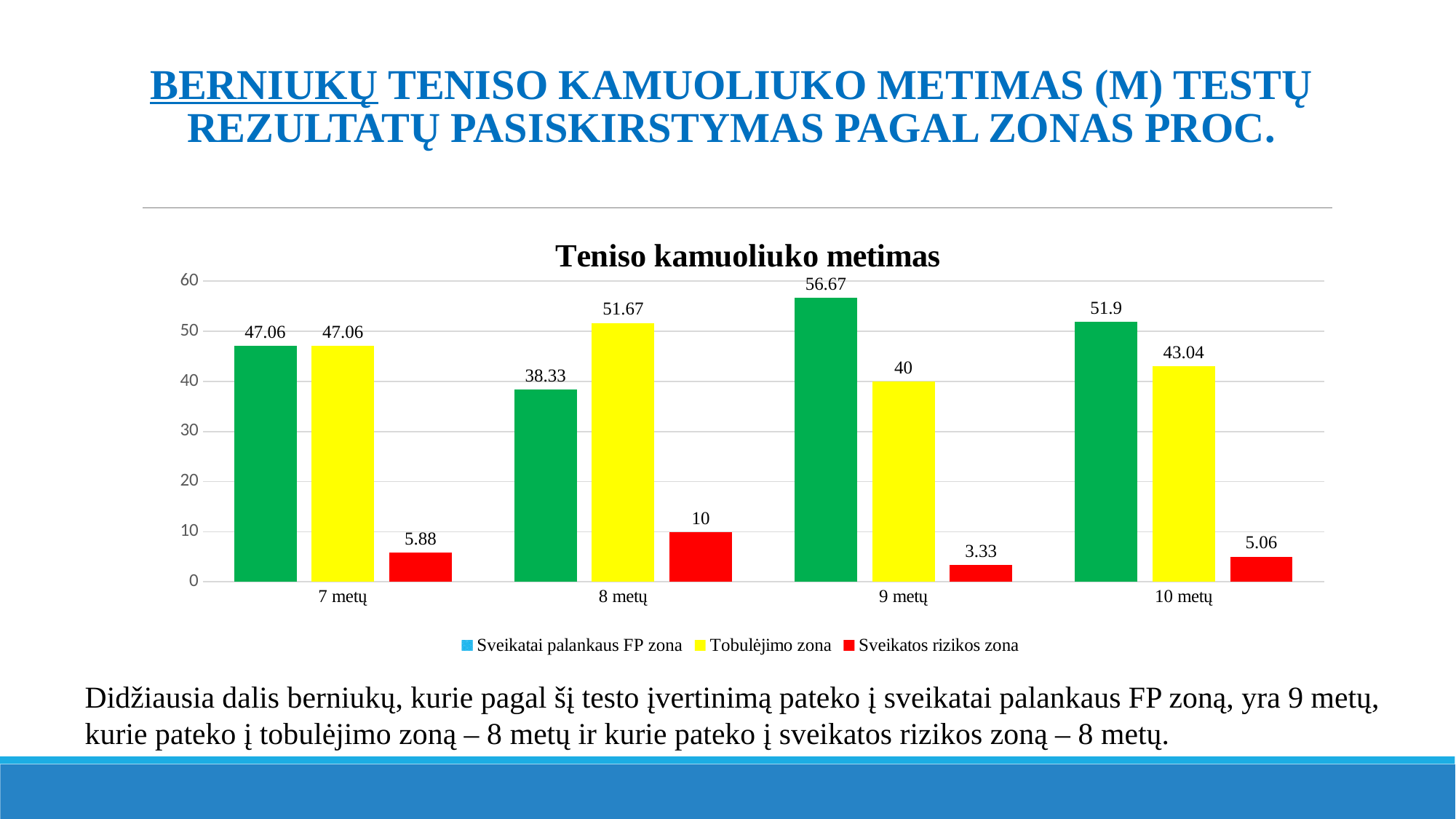
How many age groups are shown on the x axis? 4 Is the value for Sveikatai palankaus FP zona at 10 metų greater or less than 50? greater Which age group has the highest value for Sveikatai palankaus FP zona? 9 metų What is the value for Tobulėjimo zona at 8 metų? 51.67 What is the title of the chart? Teniso kamuoliuko metimas How many series does the legend list? 3 What is the value for Sveikatos rizikos zona at 10 metų? 5.06 Which age group has the lowest value for Sveikatos rizikos zona? 9 metų What kind of chart is shown? bar chart What is the difference between the Tobulėjimo zona values for 8 metų and 10 metų? 8.63 What is the value for Sveikatai palankaus FP zona at 9 metų? 56.67 Which is larger at 8 metų: Sveikatai palankaus FP zona or Tobulėjimo zona? Tobulėjimo zona